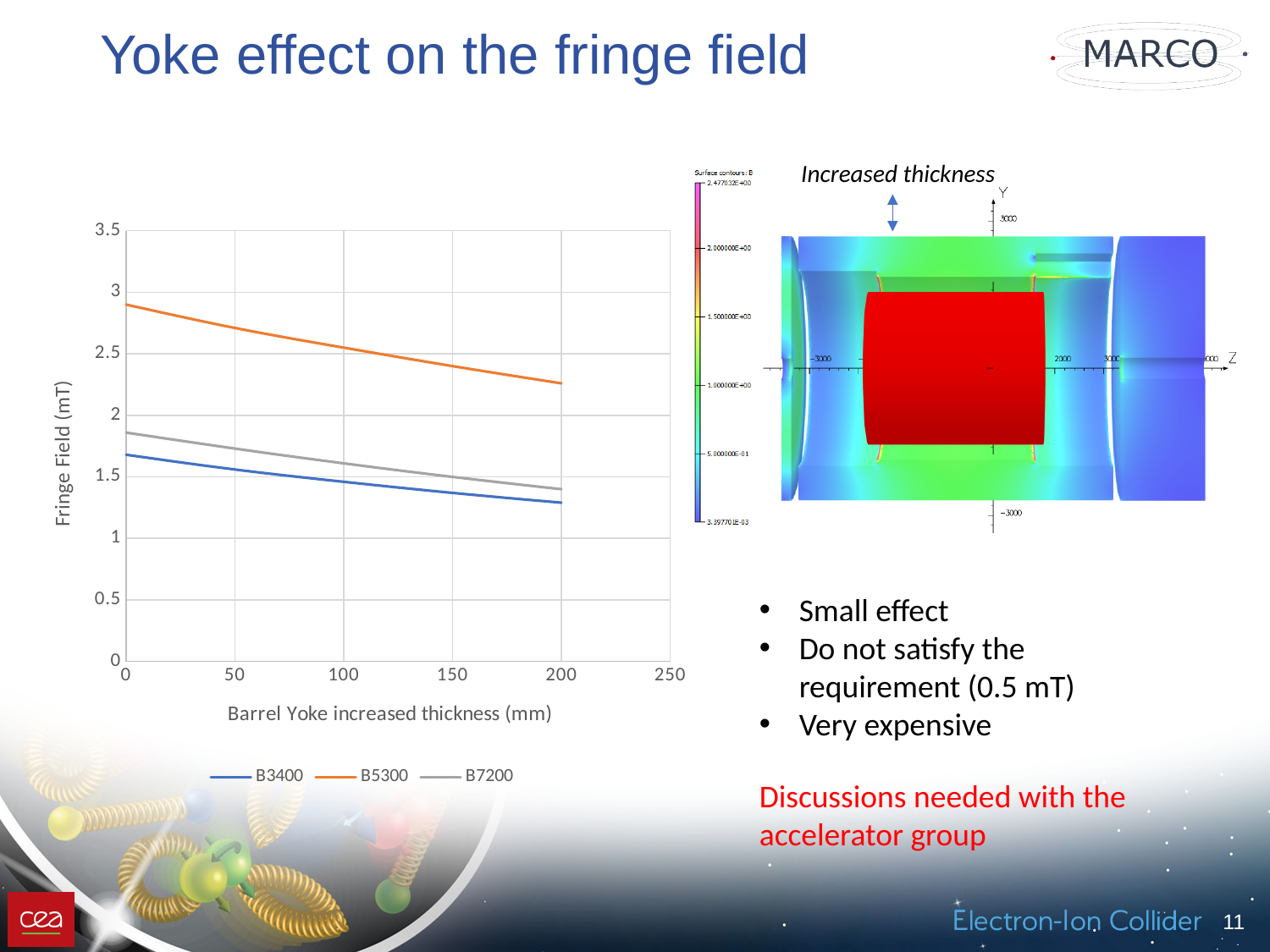
At 0 mm increased thickness, which series has the larger fringe field, B5300 or B3400? B5300 What kind of chart is shown on the slide? line chart What is the title of the x axis of the chart? Barrel Yoke increased thickness (mm) Does the fringe field for B5300 rise or fall as the barrel yoke increased thickness grows? fall Is the fringe field for B5300 at 0 mm increased thickness greater or less than 2.5? greater Does the fringe field for B3400 rise or fall along the x axis? fall Is the fringe field for B3400 at 200 mm increased thickness greater or less than 1.5? less How many series does the legend of the chart list? 3 Is the fringe field for B7200 at 0 mm increased thickness greater or less than 1.5? greater Which series has the highest fringe field values across the chart? B5300 What is the title of the y axis of the chart? Fringe Field (mT) Which series has the lowest fringe field values across the chart? B3400